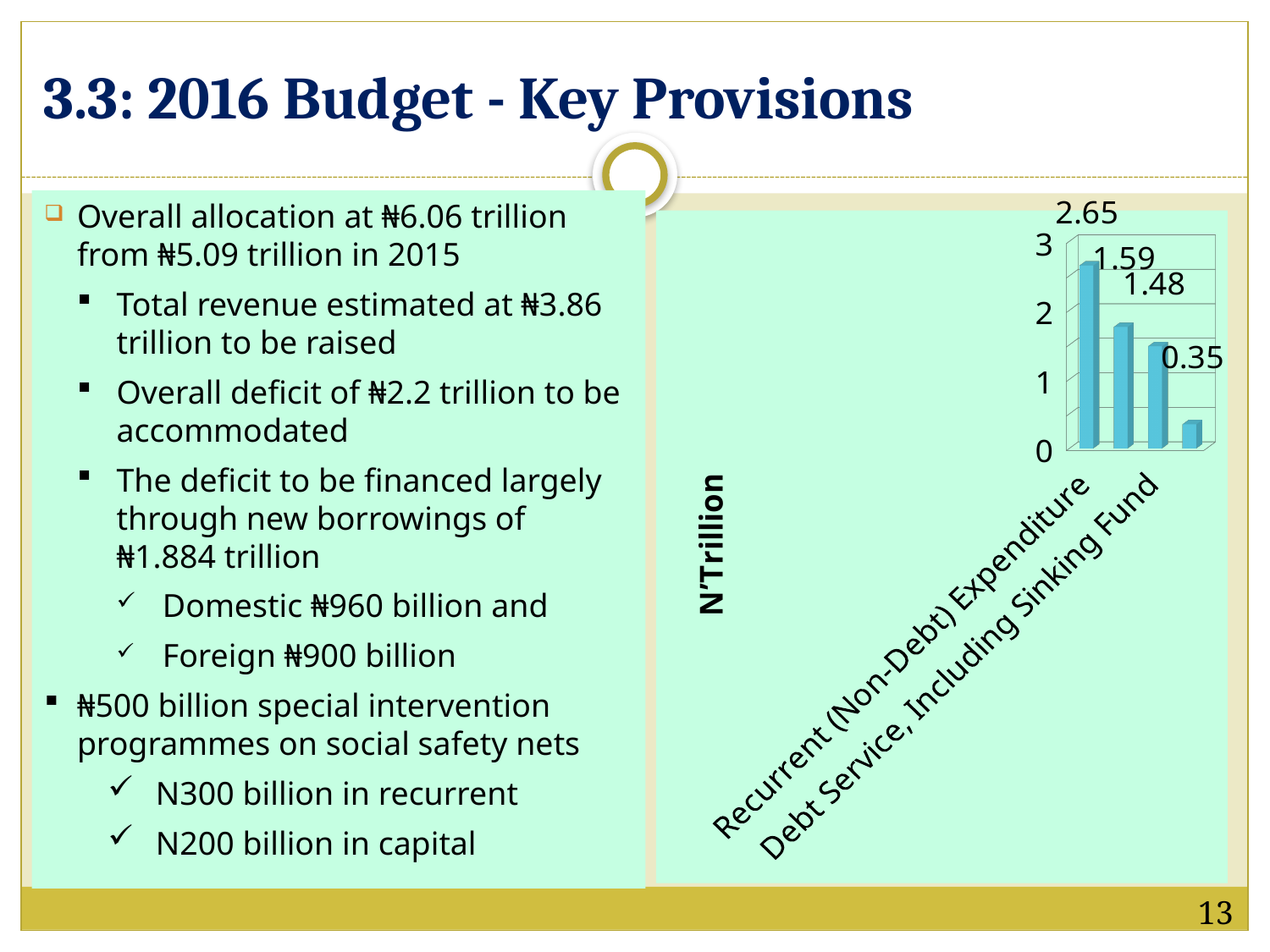
What is the label on the vertical axis of the chart? N'Trillion What is the value for Recurrent (Non-Debt) Expenditure in the chart? 2.65 Which is larger: Recurrent (Non-Debt) Expenditure or Debt Service, Including Sinking Fund? Recurrent (Non-Debt) Expenditure What is the lowest value shown in the chart? 0.35 What is the difference between the values for Recurrent (Non-Debt) Expenditure and Debt Service, Including Sinking Fund? 1.17 Is the value for Recurrent (Non-Debt) Expenditure greater or less than 2? greater Do the bar values rise or fall from left to right across the chart? fall How many bars are plotted in the chart? 4 What is the value for Debt Service, Including Sinking Fund in the chart? 1.48 Which category has the highest value in the chart? Recurrent (Non-Debt) Expenditure What kind of chart is shown on the slide? bar chart What is the highest value shown in the chart? 2.65